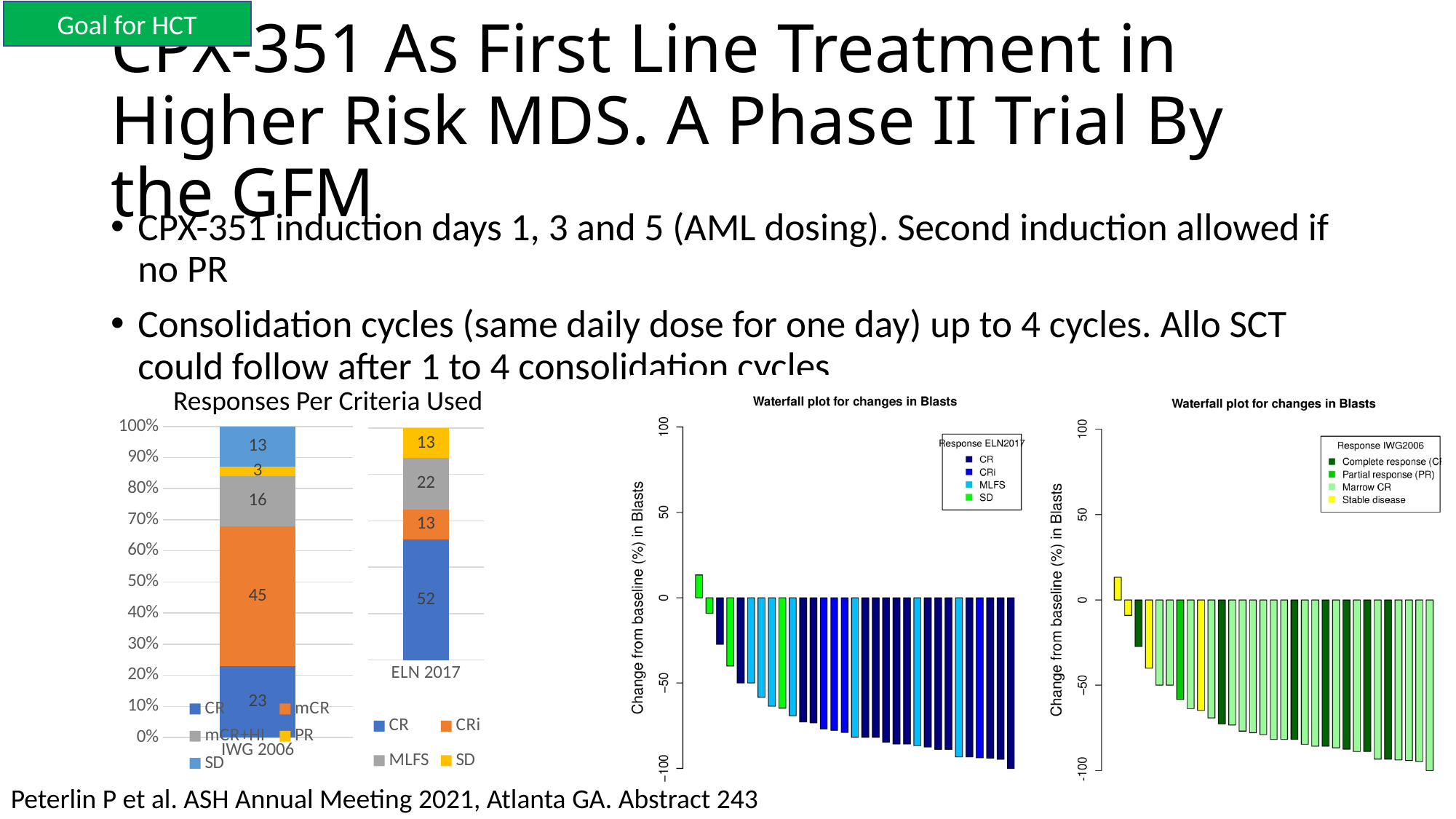
In the 'Responses Per Criteria Used' chart, how many segments make up the IWG 2006 bar? 5 In the 'Responses Per Criteria Used' chart, what is the value of the MLFS segment in the ELN 2017 bar? 22 In the 'Responses Per Criteria Used' chart, which segment is the smallest in the IWG 2006 bar? PR In the 'Responses Per Criteria Used' chart, which segment is the largest in the IWG 2006 bar? mCR What type of chart is 'Responses Per Criteria Used'? Stacked bar chart In the 'Responses Per Criteria Used' chart, which is larger: the mCR+HI segment in IWG 2006 or the MLFS segment in ELN 2017? MLFS in ELN 2017 In the 'Responses Per Criteria Used' chart, what is the difference between the CR value in the ELN 2017 bar and the CR value in the IWG 2006 bar? 29 In the 'Responses Per Criteria Used' chart, what is the total of the segments in the ELN 2017 bar? 100 In the 'Responses Per Criteria Used' chart, what is the value of the mCR segment in the IWG 2006 bar? 45 In the 'Responses Per Criteria Used' chart, what is the value of the CR segment in the ELN 2017 bar? 52 In the waterfall plot on the far right, how many response categories does the 'Response IWG2006' legend list? 4 In the 'Responses Per Criteria Used' chart, what is the value of the PR segment in the IWG 2006 bar? 3